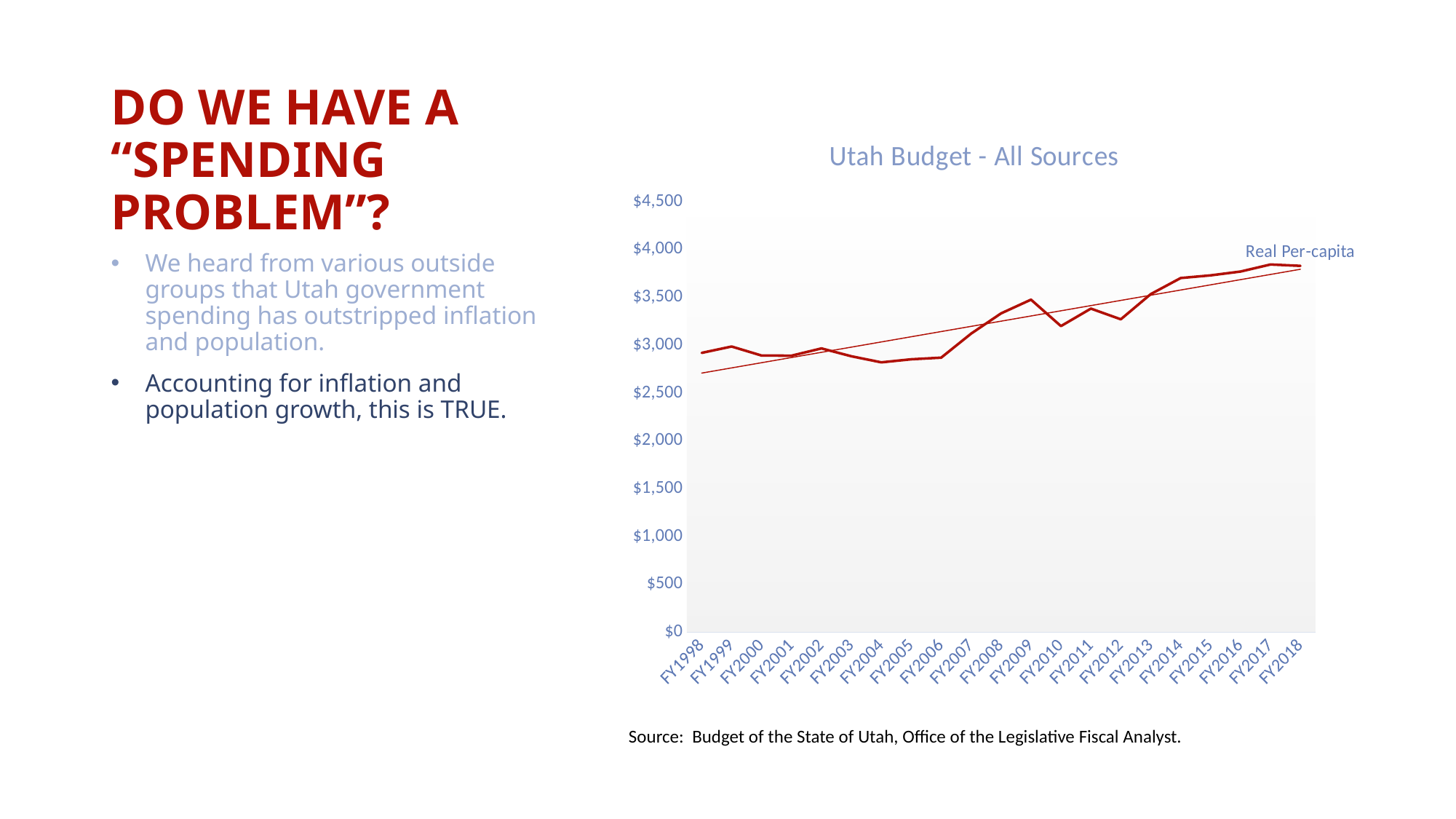
Is the Real Per-capita value for FY1998 greater or less than $3,000? less Is the Real Per-capita value for FY2018 greater or less than $3,500? greater Which fiscal year has the higher Real Per-capita value, FY2009 or FY2010? FY2009 What is the title of the chart? Utah Budget - All Sources How many fiscal years are plotted along the x axis of the chart? 21 Which fiscal year has the higher Real Per-capita value, FY2008 or FY2014? FY2014 Is the Real Per-capita value for FY2004 greater or less than $3,000? less What is the label of the data series plotted in the chart? Real Per-capita What kind of chart is shown on the slide? Line chart Overall, does the Real Per-capita line rise or fall from FY1998 to FY2018? Rise